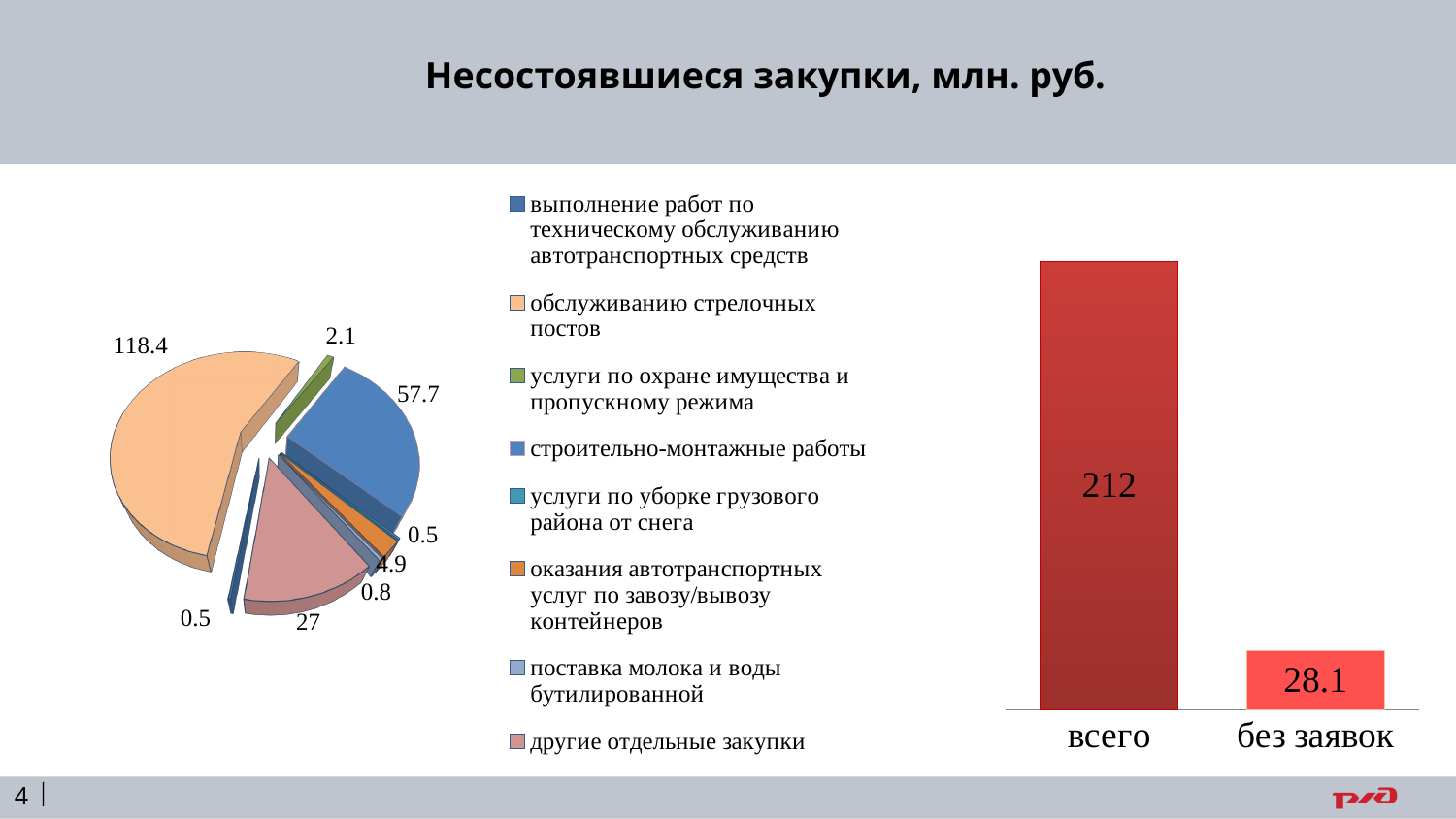
On the pie chart on the left, what is the value of the slice for "другие отдельные закупки"? 27 On the bar chart on the right, what is the difference between the values for "всего" and "без заявок"? 183.9 On the bar chart on the right, what is the value for "без заявок"? 28.1 On the pie chart on the left, what is the value of the slice for "обслуживанию стрелочных постов"? 118.4 What is the title of the slide containing the charts? Несостоявшиеся закупки, млн. руб. On the pie chart on the left, what is the value of the slice for "услуги по охране имущества и пропускному режиму"? 2.1 On the pie chart on the left, which category has the largest slice? обслуживанию стрелочных постов On the pie chart on the left, how many entries does the legend list? 8 What kind of chart is shown on the right side of the slide? bar chart On the bar chart on the right, which category has the larger value, "всего" or "без заявок"? всего On the bar chart on the right, how many bars are shown? 2 On the bar chart on the right, what is the value for "всего"? 212